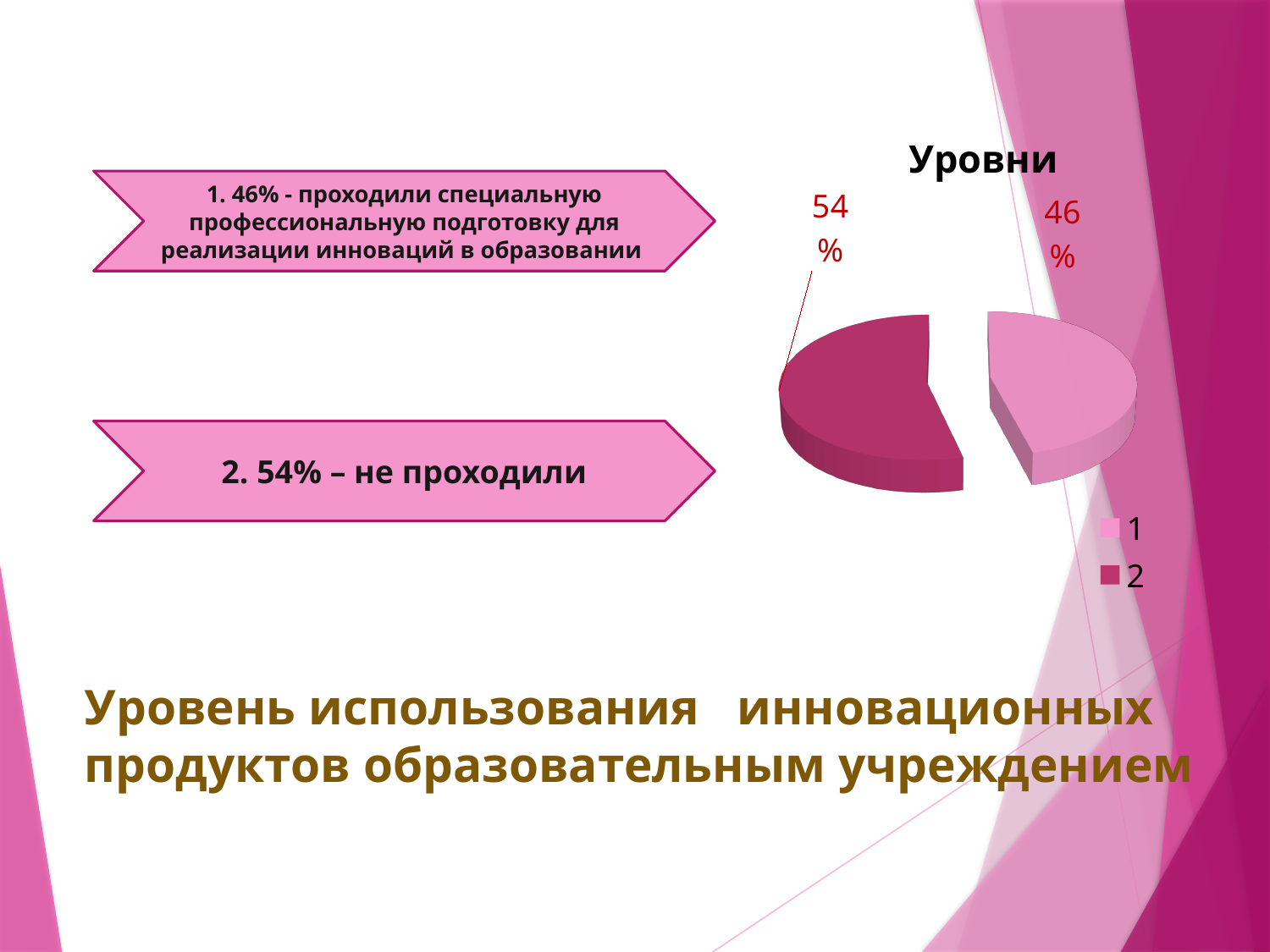
What kind of chart is shown on the slide? pie chart What is the difference in percentage points between the slice for category 2 and the slice for category 1? 8 How many slices does the pie chart have? 2 What share of the pie does category 2 have? 54% Which category has the smallest slice of the pie? 1 Which category has the largest slice of the pie? 2 Which legend entry is shown in the darker pink colour? 2 Is the share for category 2 greater or less than 50%? greater How many entries does the legend list? 2 Which slice is larger, category 1 or category 2? 2 What is the title of the chart? Уровни What share of the pie does category 1 have? 46%